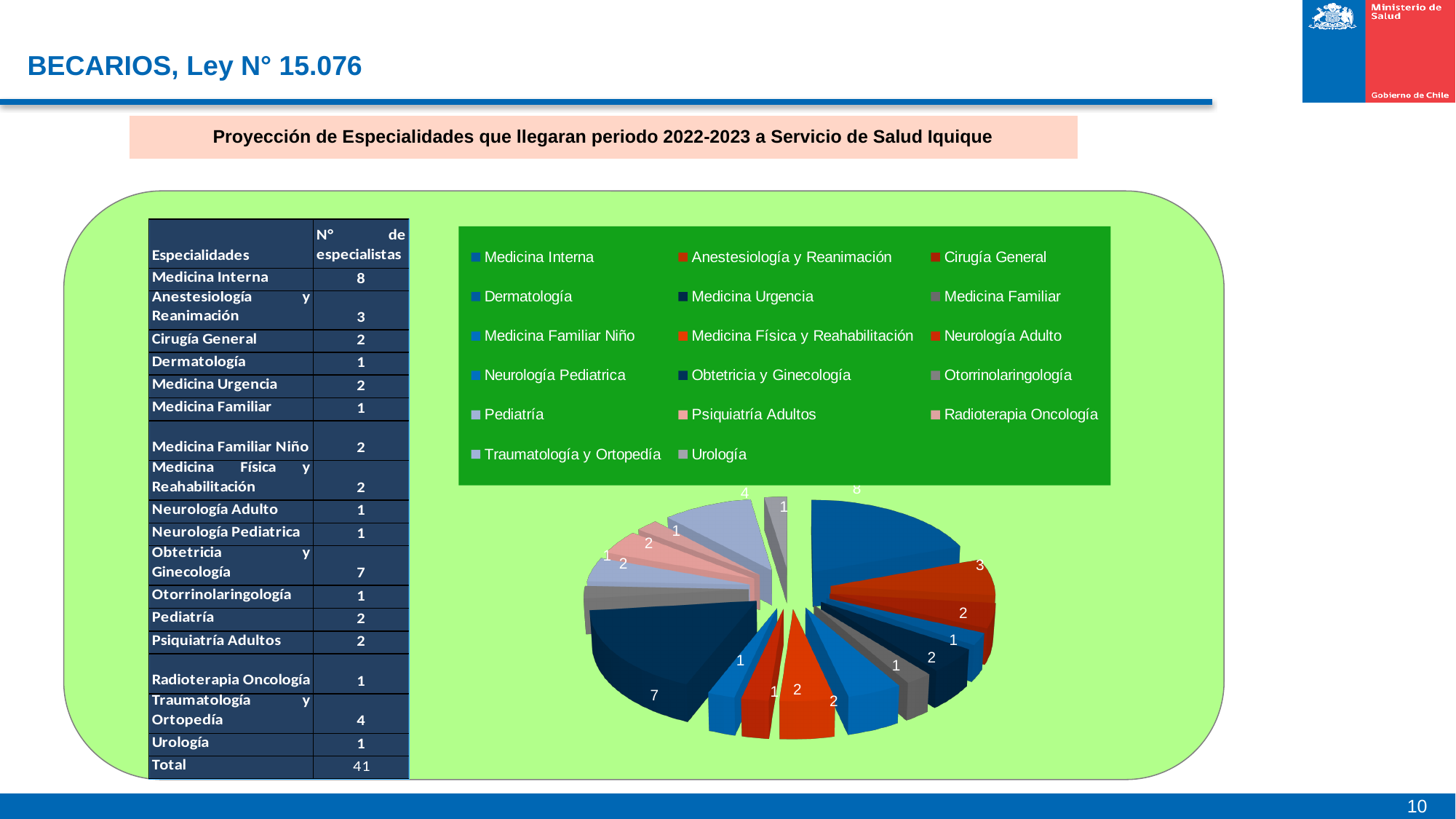
What is the number of specialists for Traumatología y Ortopedía? 4 What kind of chart is shown on the slide? pie chart Which specialty has the largest slice in the pie chart? Medicina Interna How many specialties does the chart legend list? 17 What is the difference between the values for Obstetricia y Ginecología and Traumatología y Ortopedía? 3 What is the number of specialists for Anestesiología y Reanimación? 3 How many slices does the pie chart have? 17 Which is larger, the value for Obstetricia y Ginecología or the value for Traumatología y Ortopedía? Obstetricia y Ginecología What is the difference between the values for Medicina Interna and Obstetricia y Ginecología? 1 What is the number of specialists for Medicina Interna? 8 What is the total number of specialists across all specialties shown? 41 What is the number of specialists for Obstetricia y Ginecología? 7